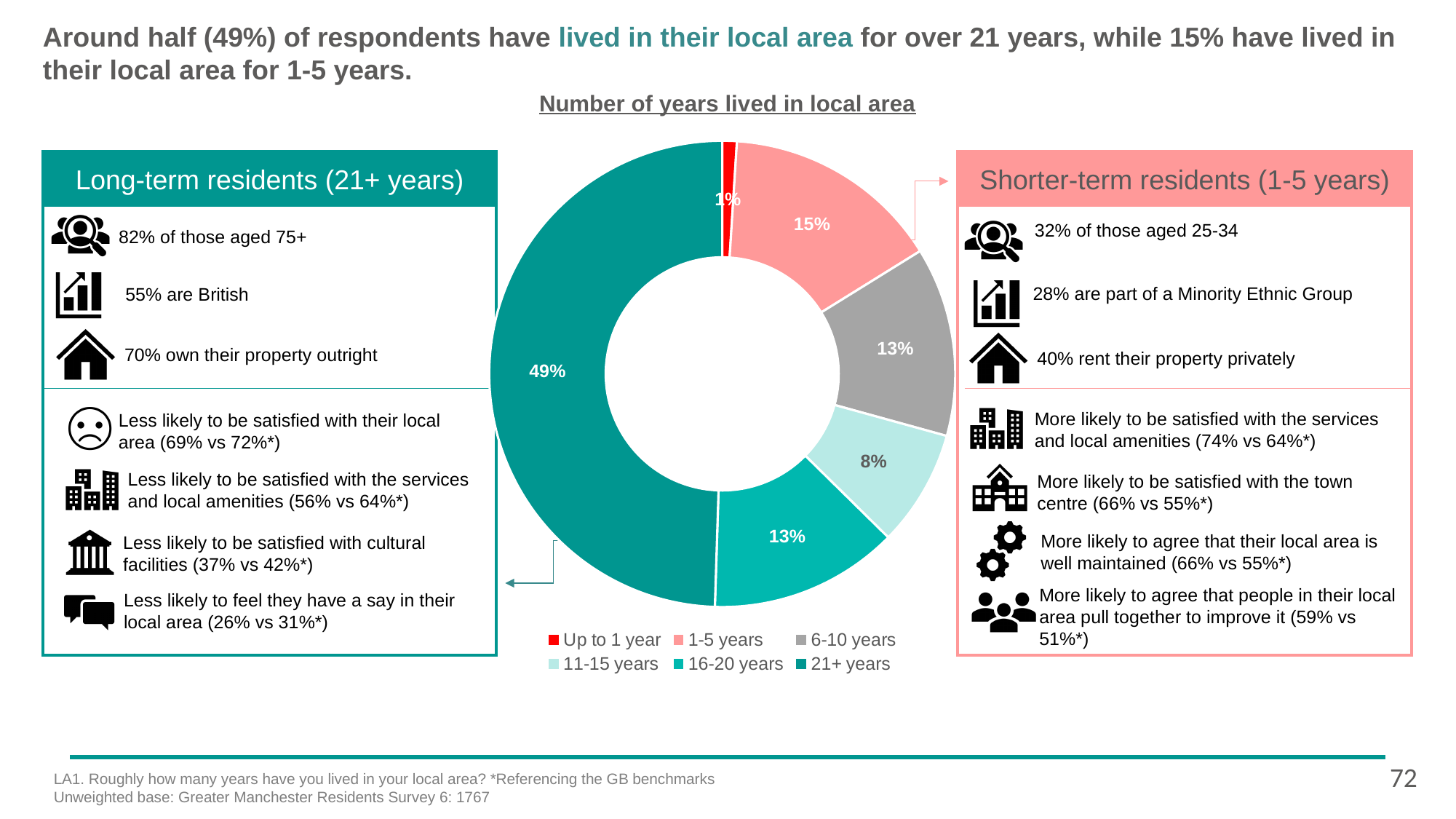
What percentage of respondents have lived in their local area for 21+ years? 49% What type of chart is shown under the title "Number of years lived in local area"? Doughnut chart Which is larger: the share for 1-5 years or the share for 11-15 years? 1-5 years Which category has the largest share of the doughnut chart? 21+ years What is the difference in percentage points between the 21+ years share and the 1-5 years share? 34 percentage points What percentage of respondents have lived in their local area for up to 1 year? 1% What percentage of respondents have lived in their local area for 11-15 years? 8% What is the combined share of respondents who have lived in their local area for 6-10 years and 16-20 years? 26% What colour is the 21+ years segment in the doughnut chart? Dark teal What percentage of respondents have lived in their local area for 1-5 years? 15% Which category has the smallest share of the doughnut chart? Up to 1 year How many categories does the legend of the doughnut chart list? 6